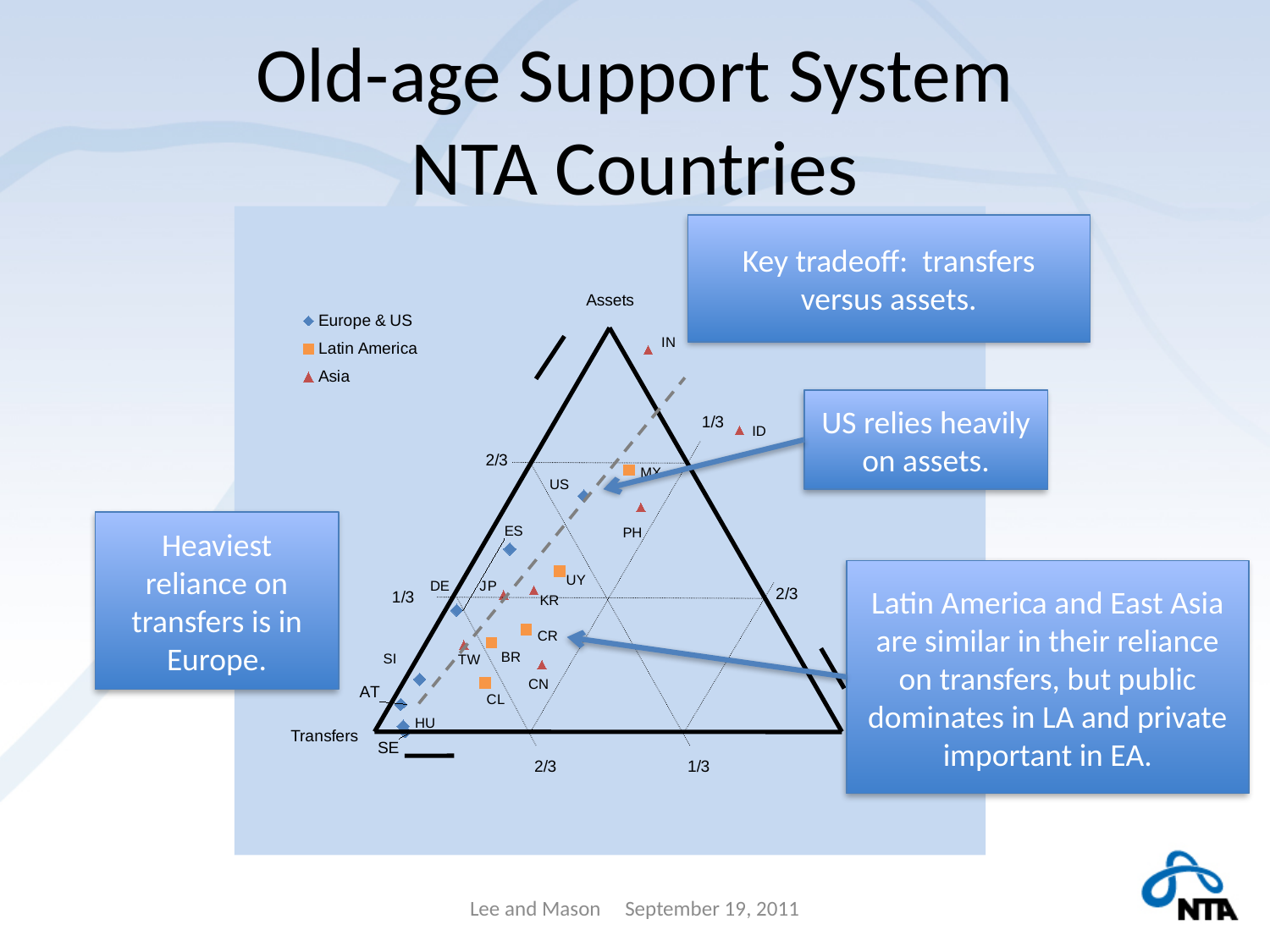
Which series has the fewest plotted points? Latin America Which country's point lies closest to the Assets vertex? IN What kind of chart is shown on the slide? Ternary (triangle) scatter plot How many series does the legend list? 3 Which point is closer to the Assets vertex, US or SE? US Which series does the point labelled KR belong to? Asia Is the asset share for IN greater or less than 2/3? greater What are the three series listed in the legend? Europe & US, Latin America, Asia Which country's point lies closest to the Transfers vertex? SE Which series does the point labelled HU belong to? Europe & US Which series does the point labelled MX belong to? Latin America Which vertex of the triangle is labelled at the top? Assets